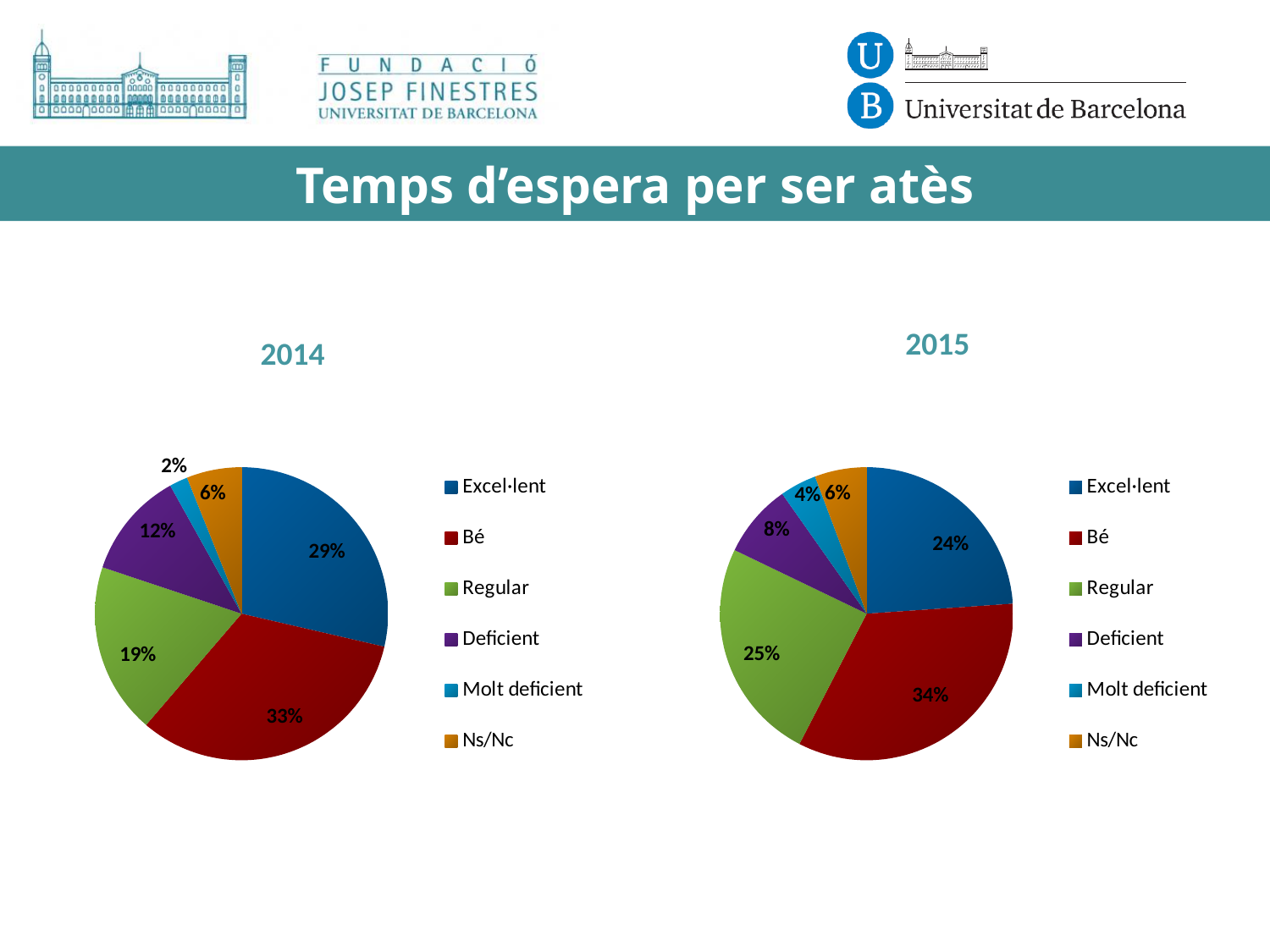
In the 2014 pie chart, which category has the largest slice? Bé In the 2014 pie chart, which category has the smallest slice? Molt deficient What is the title of the slide above the two charts? Temps d'espera per ser atès What type of chart is used for the 2014 data? Pie chart In the 2015 pie chart, what percentage is labelled for Excel·lent? 24% How many categories does the legend of the 2015 pie chart list? 6 In the 2014 pie chart, which is larger: Regular or Deficient? Regular In the 2014 pie chart, what percentage is labelled for Deficient? 12% In the 2014 pie chart, what percentage is labelled for Bé? 33% In the 2015 pie chart, which category has the smallest slice? Molt deficient In the 2015 pie chart, what is the difference between the Bé and Excel·lent percentages? 10% In the 2015 pie chart, what percentage is labelled for Regular? 25%